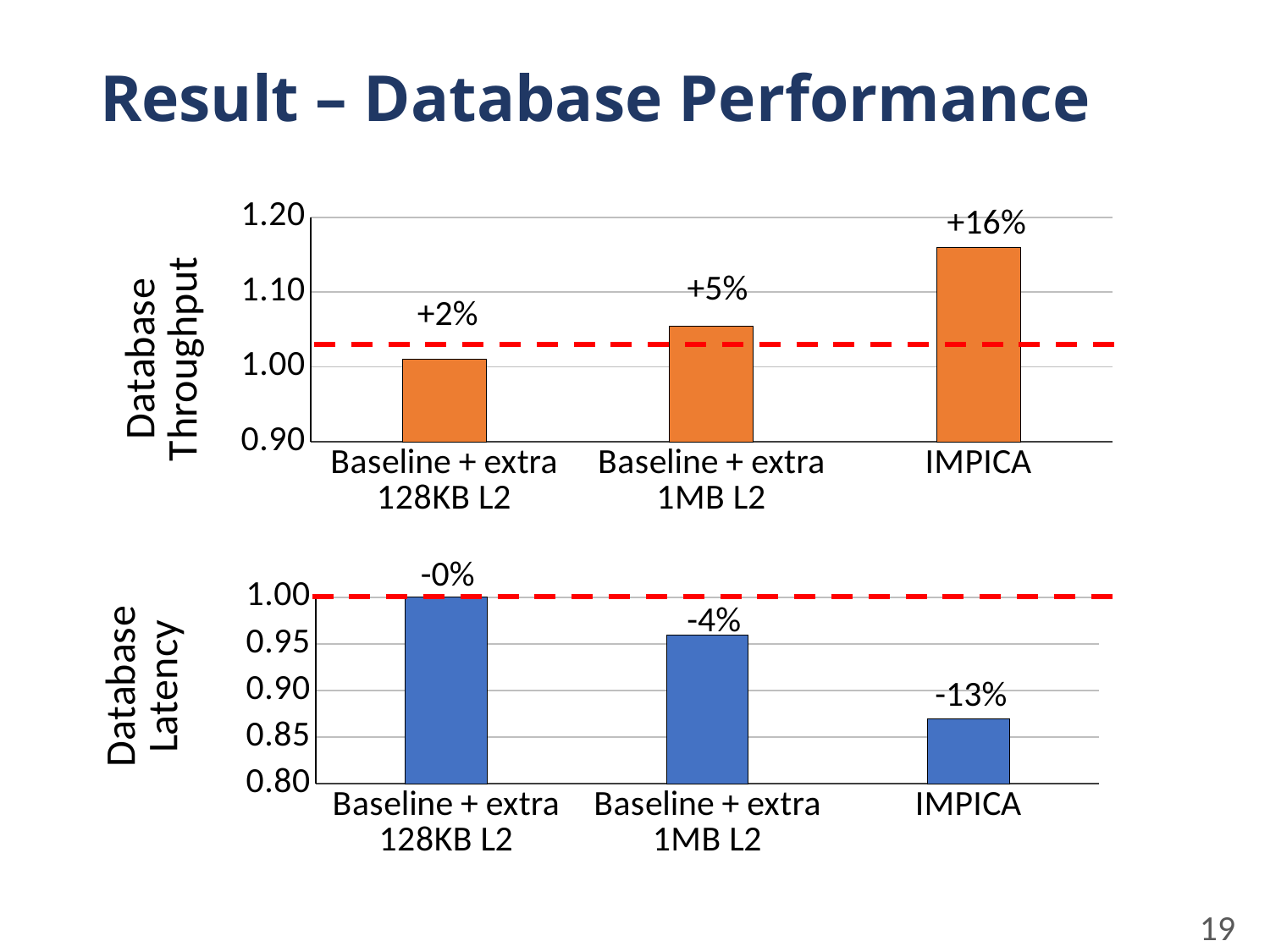
In the Database Latency chart, is the value for IMPICA greater or less than 0.90? less How many categories are shown in the Database Throughput chart? 3 What type of chart is the Database Latency chart? Bar chart In the Database Throughput chart, what label is shown above the IMPICA bar? +16% In the Database Latency chart, what label is shown above the IMPICA bar? -13% In the Database Latency chart, which category has the lowest bar? IMPICA In the Database Latency chart, what label is shown above the Baseline + extra 1MB L2 bar? -4% In the Database Throughput chart, which category has the highest bar? IMPICA In the Database Latency chart, which bar is taller: Baseline + extra 128KB L2 or Baseline + extra 1MB L2? Baseline + extra 128KB L2 In the Database Throughput chart, is the value for IMPICA greater or less than 1.10? greater In the Database Latency chart, do the bar values rise or fall from left to right? Fall In the Database Throughput chart, what label is shown above the Baseline + extra 1MB L2 bar? +5%